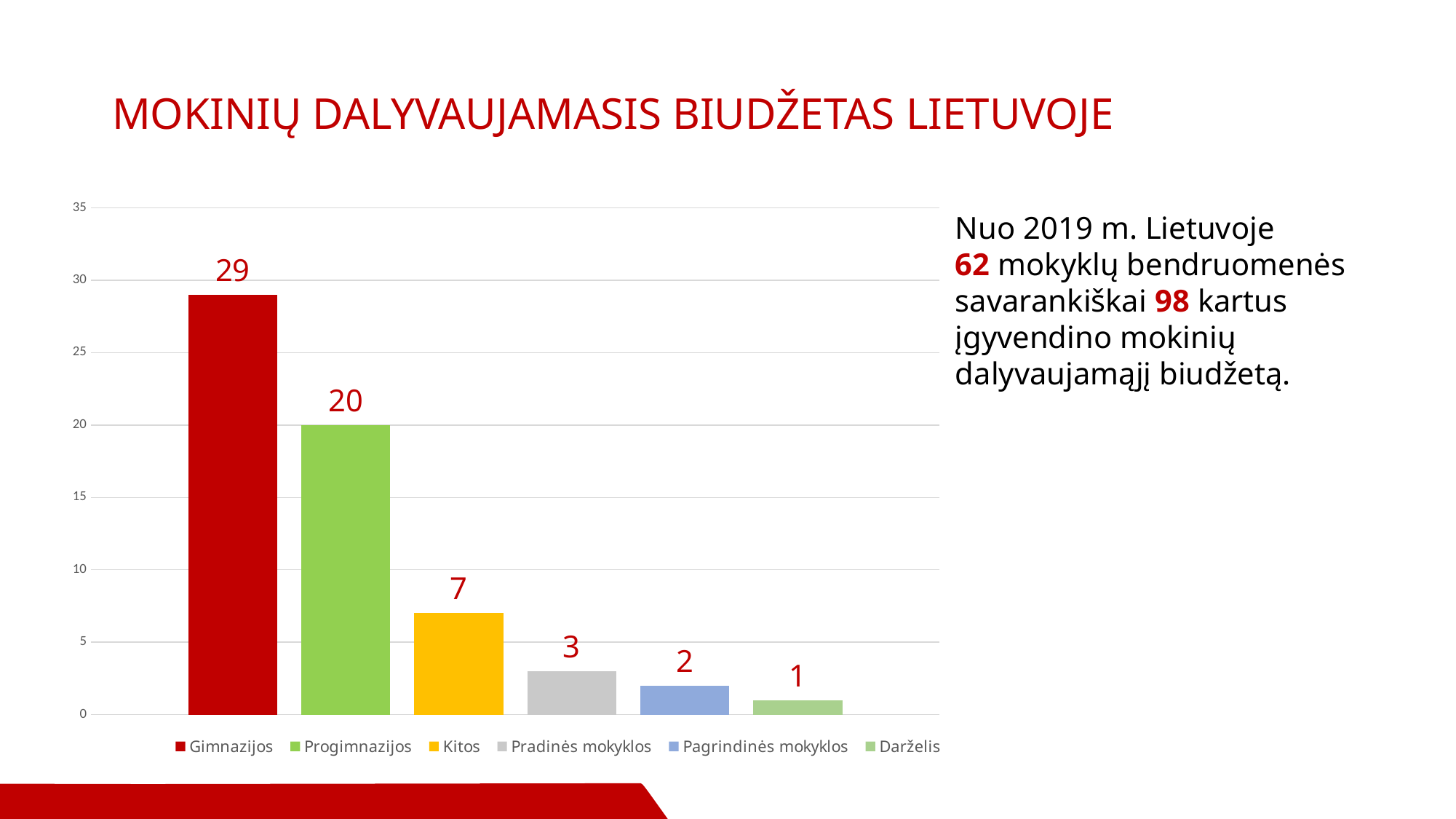
What is the value for Progimnazijos? 20 What is the value for Kitos? 7 Is the value for Progimnazijos greater or less than 15? greater What kind of chart is shown on the slide? bar chart What is the value for Gimnazijos? 29 Which category has the lowest value? Darželis Which category has the highest value? Gimnazijos What is the value for Pradinės mokyklos? 3 Which is larger, the value for Kitos or the value for Pagrindinės mokyklos? Kitos How many categories are shown in the chart? 6 What colour is the bar for Kitos? yellow What is the difference between the values for Gimnazijos and Progimnazijos? 9